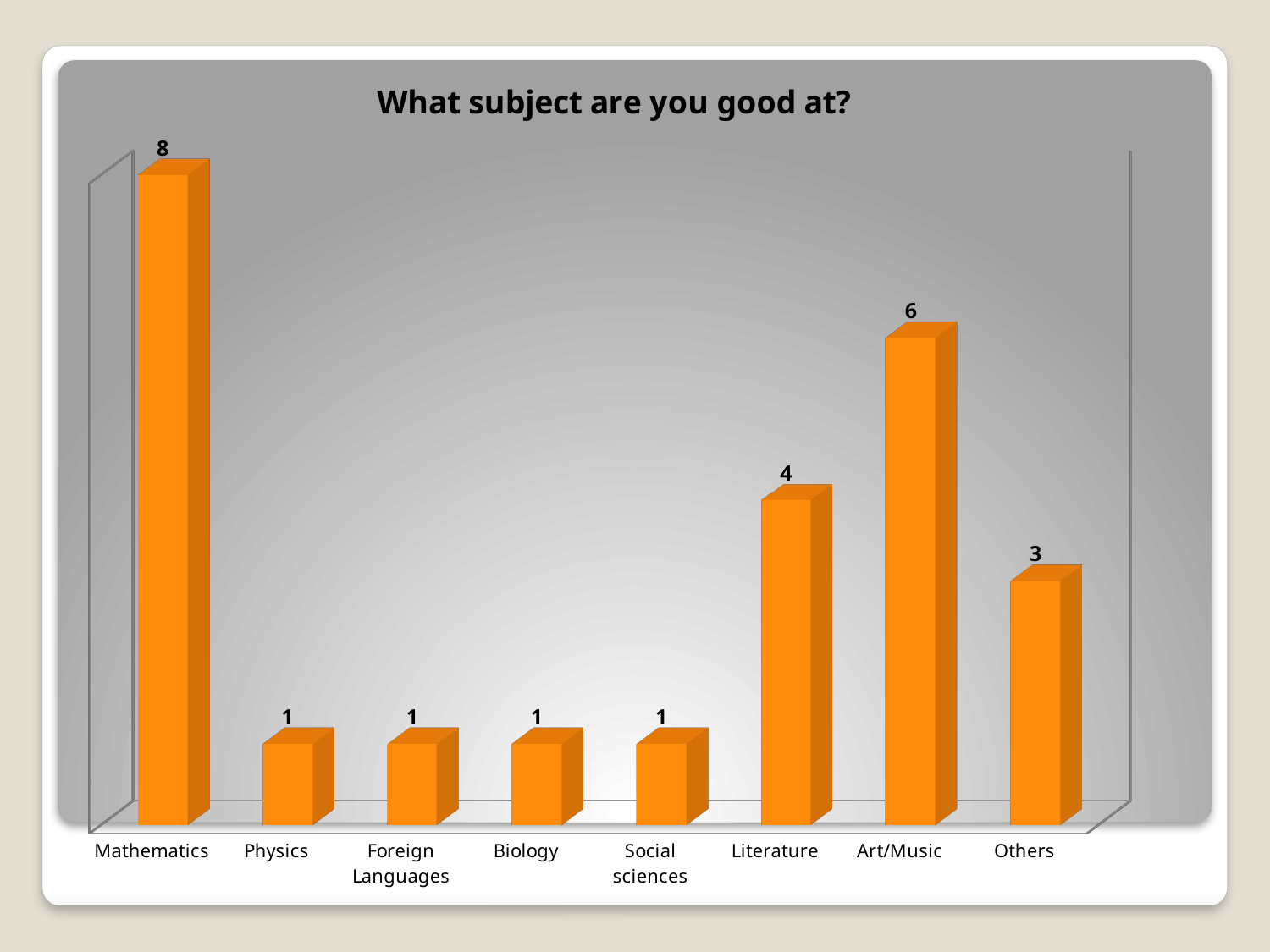
What is the title of the chart? What subject are you good at? Which is larger, the value for Literature or the value for Others? Literature What kind of chart is shown on the slide? Bar chart What is the difference between the values for Literature and Others? 1 How many subject categories are shown on the chart? 8 What is the difference between the values for Mathematics and Art/Music? 2 What is the value for Physics? 1 What is the value for Literature? 4 What is the value for Mathematics? 8 What is the value for Art/Music? 6 Which subject has the highest value? Mathematics What is the value for Others? 3